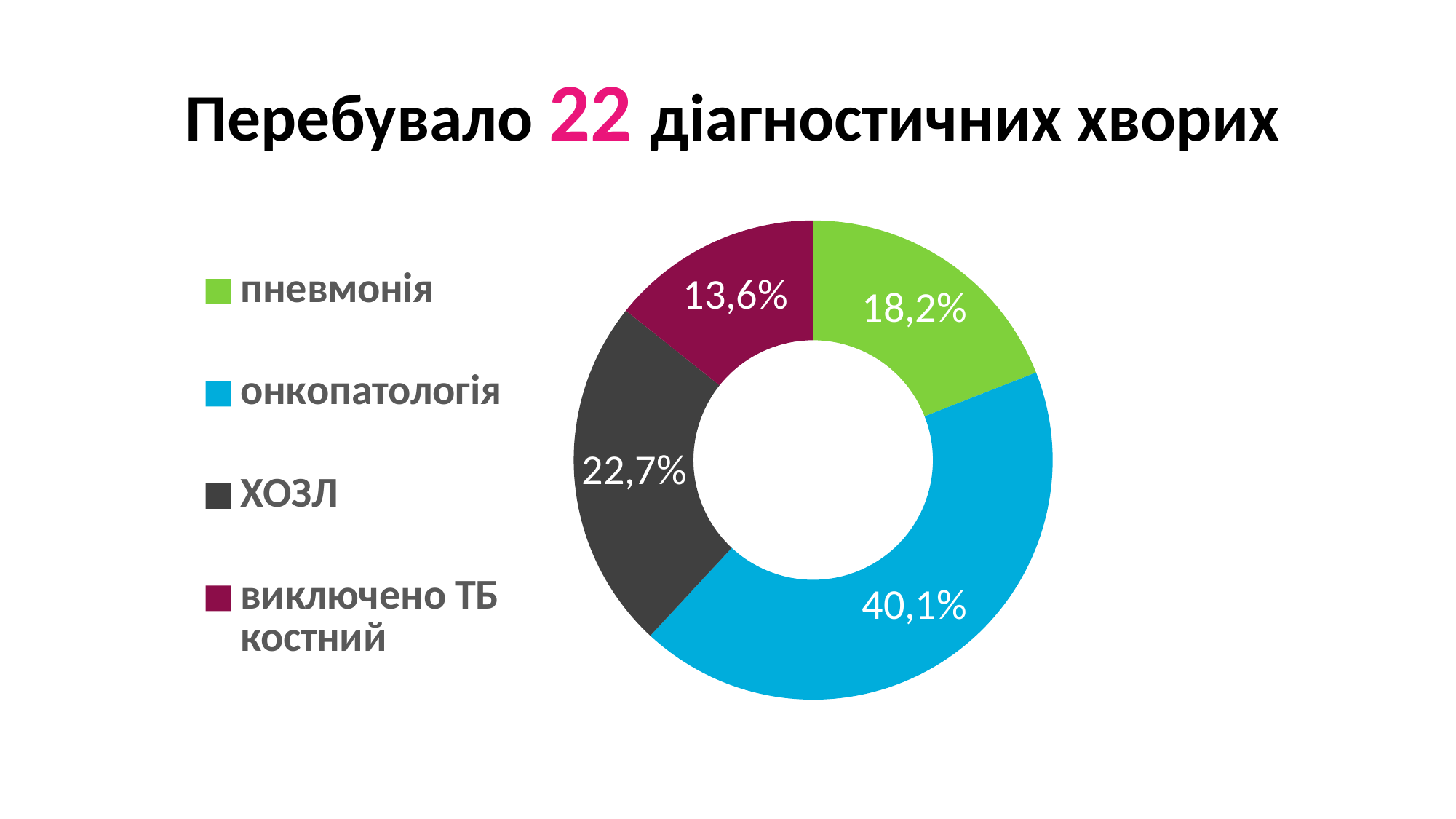
How many categories does the chart show? 4 What is the difference between the shares of онкопатологія and ХОЗЛ? 17,4% What is the value shown for виключено ТБ костний? 13,6% Which category has the smallest share of the chart? виключено ТБ костний Which category has the largest share of the chart? онкопатологія What colour is the slice for ХОЗЛ? Dark grey What kind of chart is shown on the slide? Doughnut (pie) chart Which is larger, the share for пневмонія or the share for ХОЗЛ? ХОЗЛ What share of the chart does онкопатологія account for? 40,1% What is the value shown for ХОЗЛ? 22,7% What is the value shown for пневмонія? 18,2% What number is highlighted in pink in the slide title? 22